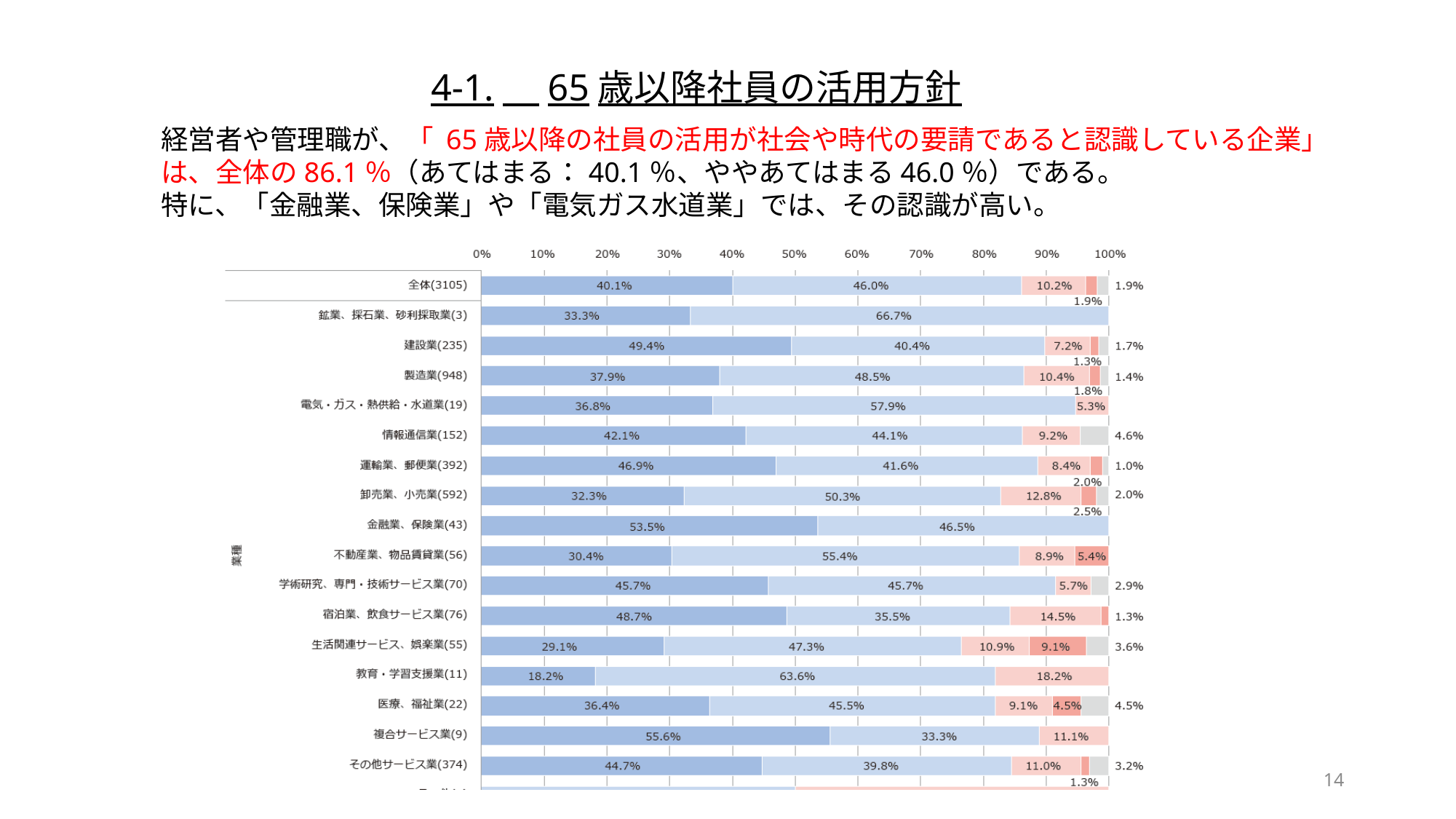
Is the first (darkest blue) segment for 情報通信業(152) greater or less than 40%? greater Which industry has the smallest first (darkest blue) segment? 教育・学習支援業(11) What is the combined total of the first two segments for 全体(3105)? 86.1% What is the value of the second (light blue) segment for 全体(3105)? 46.0% Which has a larger first (darkest blue) segment, 運輸業、郵便業(392) or 卸売業、小売業(592)? 運輸業、郵便業(392) What is the value of the second (light blue) segment for 鉱業、採石業、砂利採取業(3)? 66.7% Which industry has the largest first (darkest blue) segment? 複合サービス業(9) What is the value of the first (darkest blue) segment for 全体(3105)? 40.1% What is the value of the second (light blue) segment for 電気・ガス・熱供給・水道業(19)? 57.9% What is the value of the first (darkest blue) segment for 金融業、保険業(43)? 53.5% What is the difference between the first segment of 全体(3105) and the first segment of 製造業(948)? 2.2 percentage points What kind of chart is shown on the slide? Stacked bar chart